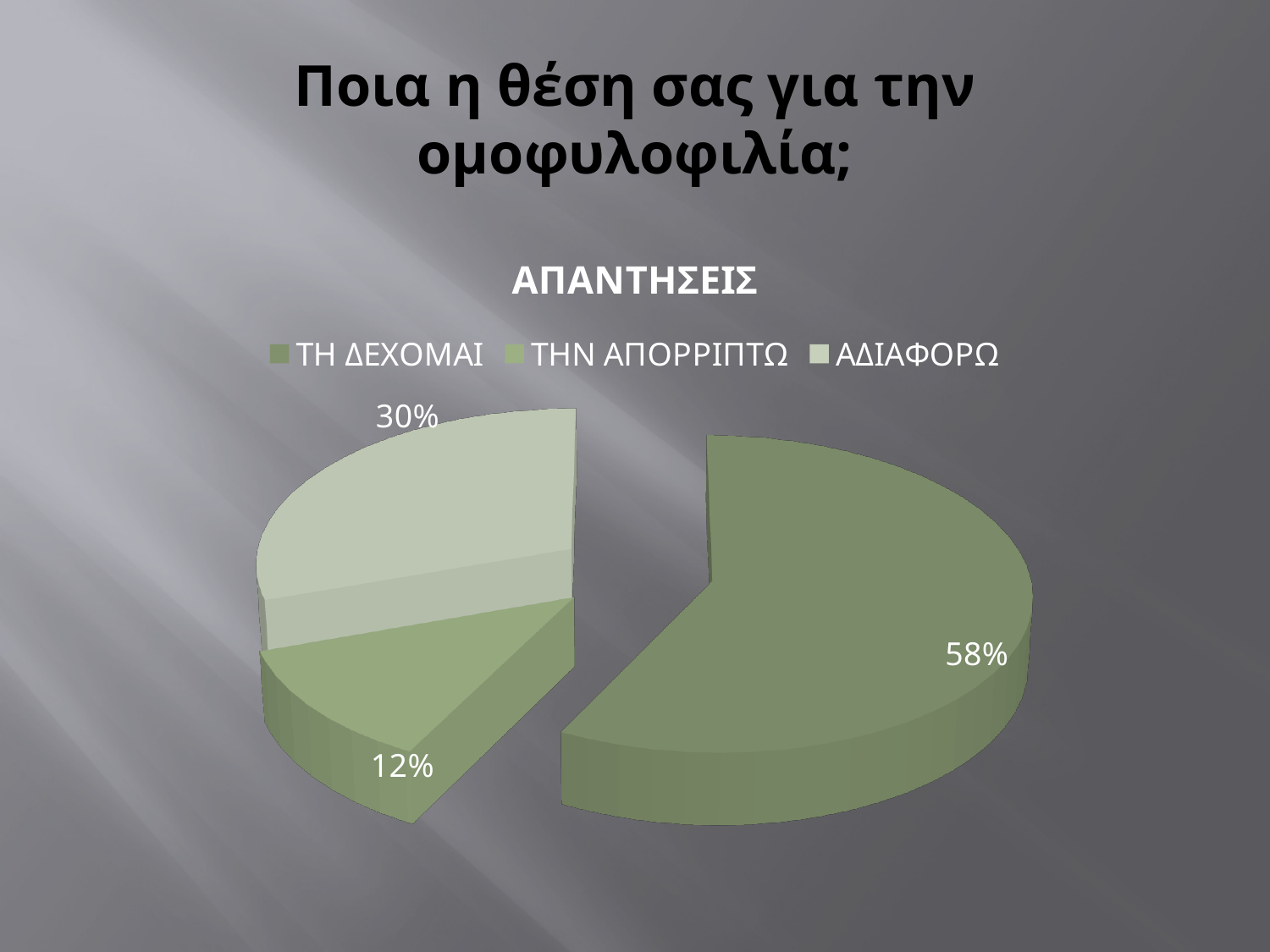
Which is larger, the slice for ΑΔΙΑΦΟΡΩ or the slice for ΤΗΝ ΑΠΟΡΡΙΠΤΩ? ΑΔΙΑΦΟΡΩ What percentage of the pie is labelled for ΤΗ ΔΕΧΟΜΑΙ? 58% Which category has the largest slice of the pie? ΤΗ ΔΕΧΟΜΑΙ What type of chart is shown on the slide? Pie chart What is the difference in percentage points between ΤΗ ΔΕΧΟΜΑΙ and ΑΔΙΑΦΟΡΩ? 28 What is the difference in percentage points between ΑΔΙΑΦΟΡΩ and ΤΗΝ ΑΠΟΡΡΙΠΤΩ? 18 How many slices does the pie chart have? 3 What is the title of the chart? ΑΠΑΝΤΗΣΕΙΣ What percentage of the pie is labelled for ΤΗΝ ΑΠΟΡΡΙΠΤΩ? 12% Which category has the smallest slice of the pie? ΤΗΝ ΑΠΟΡΡΙΠΤΩ How many categories does the legend of the chart list? 3 What percentage of the pie is labelled for ΑΔΙΑΦΟΡΩ? 30%